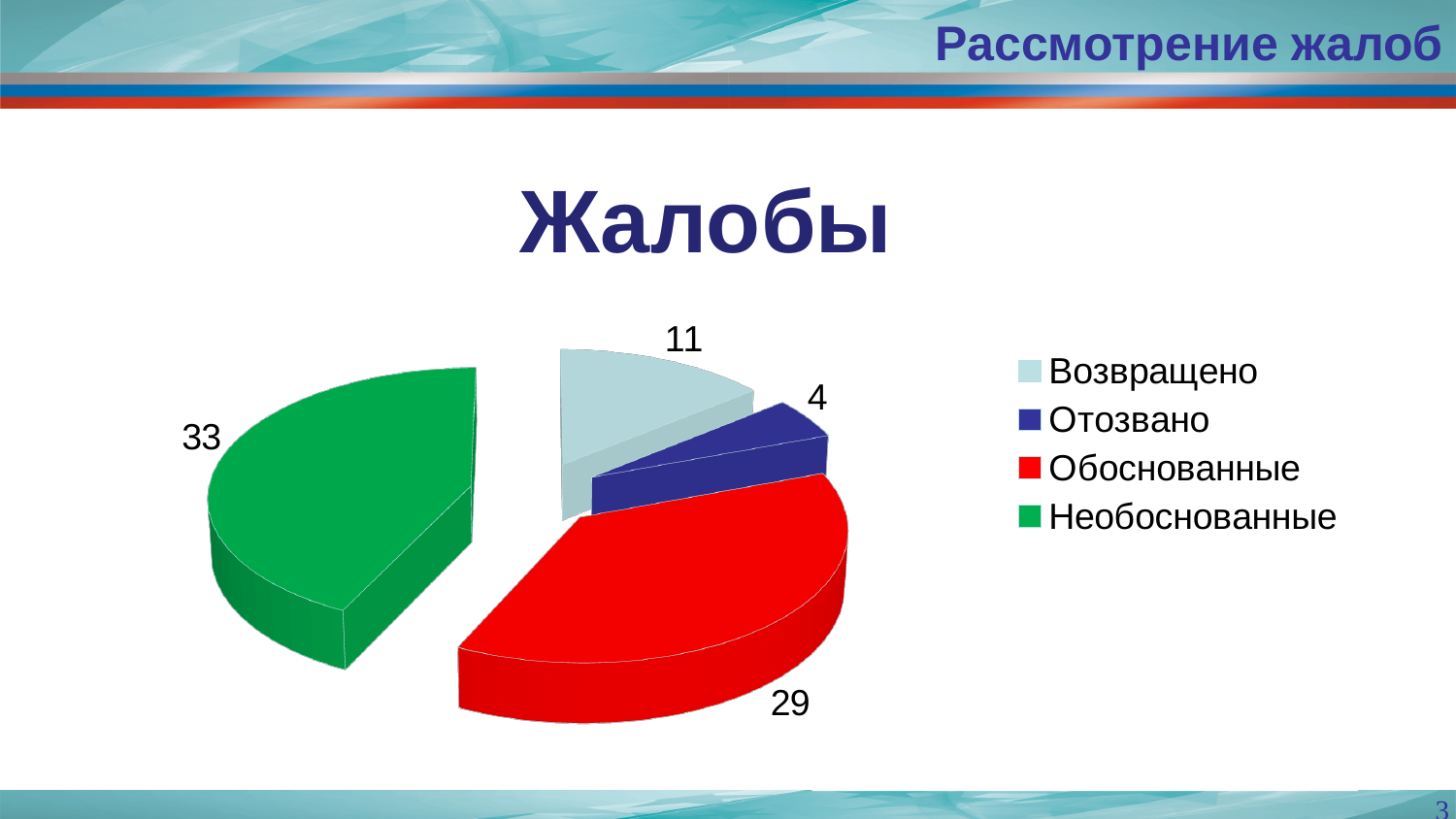
What is the value for Отозвано? 4 What is the title of the chart? Жалобы What is the difference between the values for Необоснованные and Обоснованные? 4 What kind of chart is shown on the slide? Pie chart Which is larger, the value for Возвращено or the value for Отозвано? Возвращено What is the value for Возвращено? 11 What is the value for Обоснованные? 29 Which category has the smallest value? Отозвано How many slices does the pie chart have? 4 Which category has the largest value? Необоснованные How many entries does the legend list? 4 What is the value for Необоснованные? 33